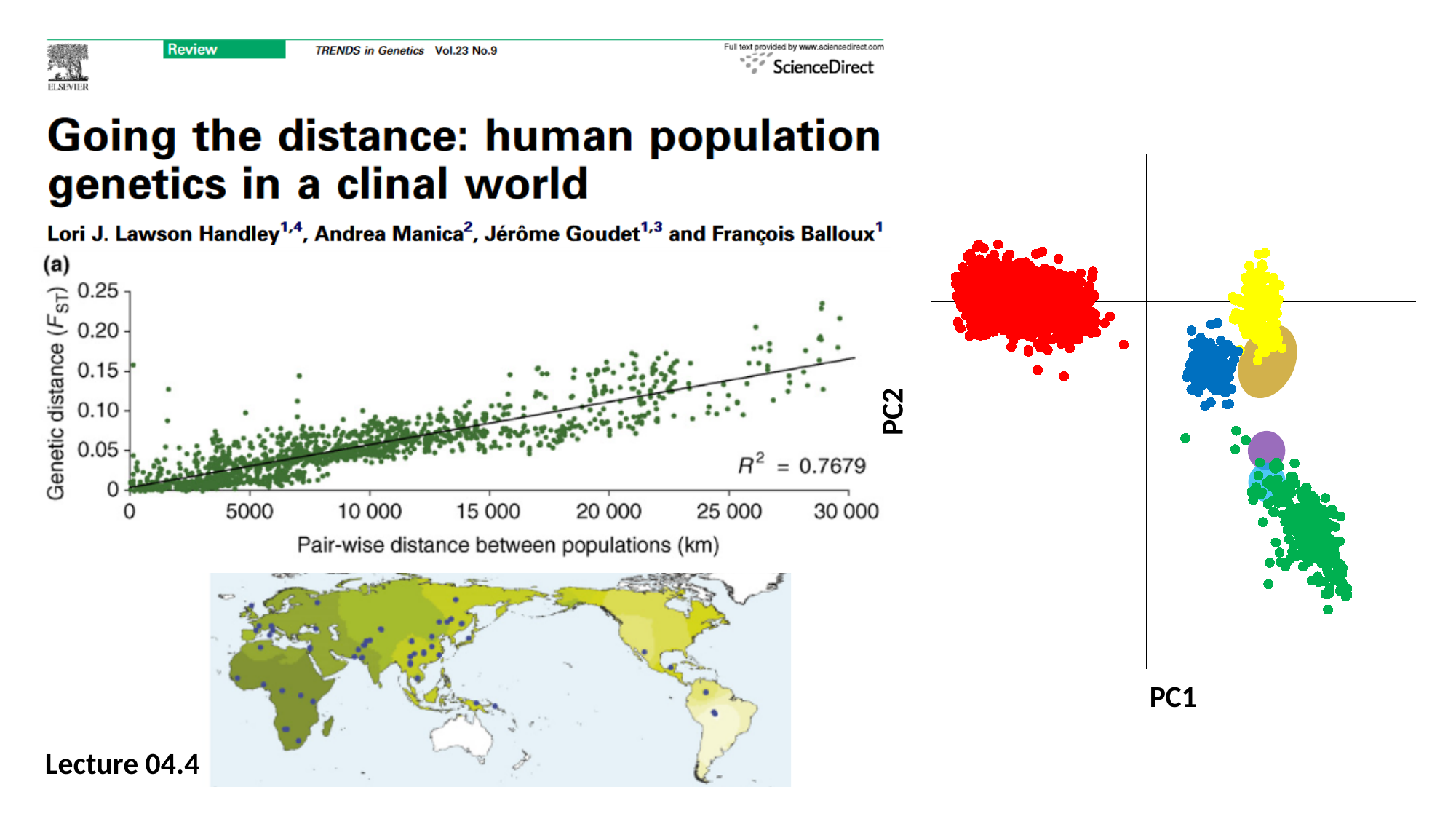
In the left chart, what is the label of the y axis? Genetic distance (FST) In the right chart, which colour cluster is furthest to the left along PC1? red In the left chart, does genetic distance rise or fall as pair-wise distance between populations increases? rise In the left chart, what R² value is printed on the plot? 0.7679 In the right chart, which colour cluster lies to the left of the vertical axis? red In the left chart, what is the highest tick value shown on the y axis? 0.25 What kind of chart is the chart on the left showing genetic distance against pair-wise distance? scatter plot In the left chart, what is the label of the x axis? Pair-wise distance between populations (km) In the left chart, what is the highest tick value shown on the x axis? 30 000 What kind of chart is the chart on the right with PC1 and PC2 axes? scatter plot In the right chart, which colour cluster extends lowest along PC2? green